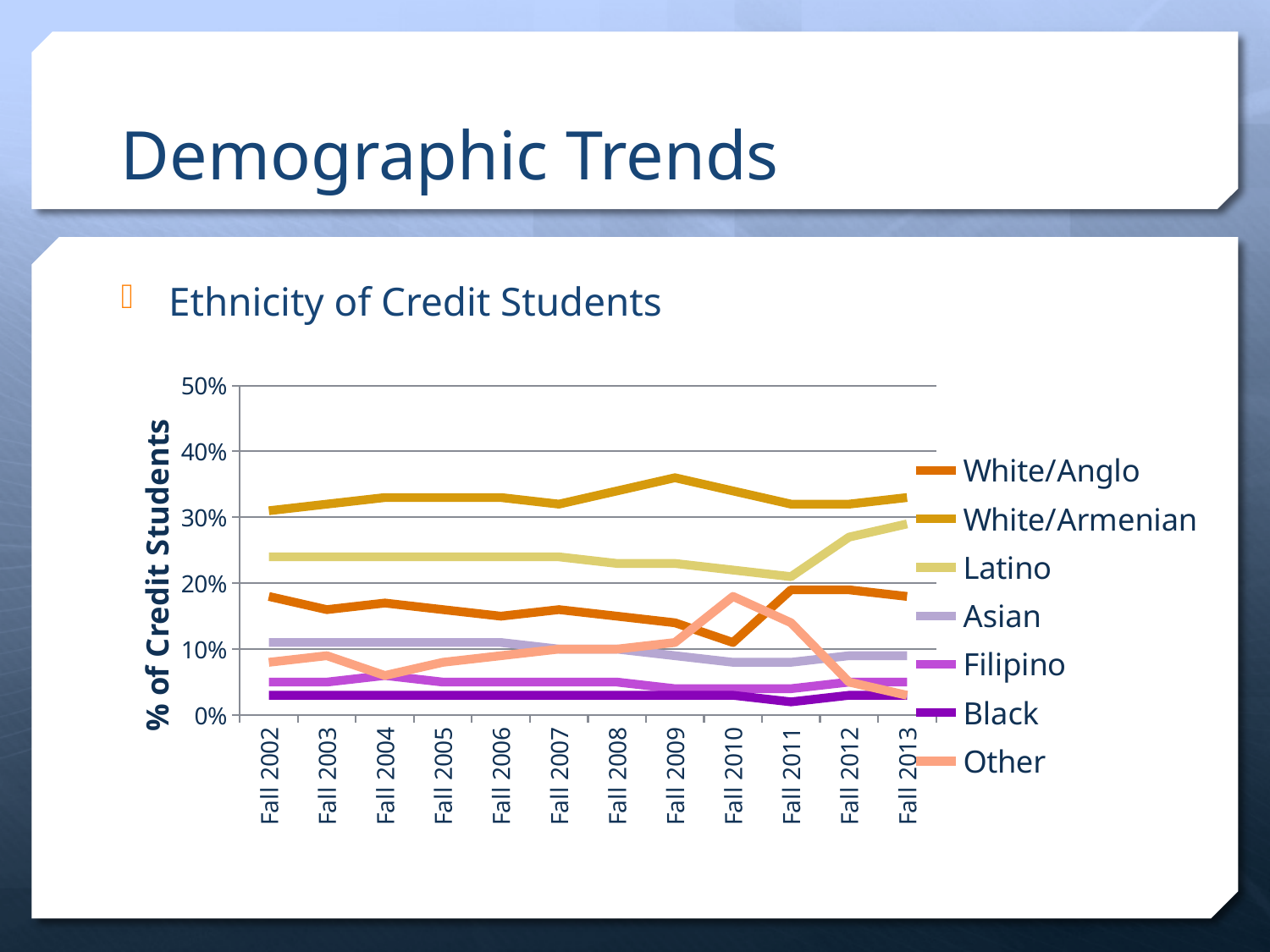
What kind of chart is shown on the slide? Line chart Does the Other series rise or fall from Fall 2010 to Fall 2013? Fall What is the label on the vertical axis? % of Credit Students Is the value for White/Anglo in Fall 2010 greater or less than 20%? less Is the value for Other in Fall 2010 greater or less than 10%? greater How many Fall terms are plotted along the x axis? 12 Which series has the highest value in Fall 2013? White/Armenian How many series does the legend list? 7 In Fall 2013, which is larger: Latino or White/Anglo? Latino Is the value for White/Armenian in Fall 2009 greater or less than 30%? greater Does the Latino series rise or fall from Fall 2011 to Fall 2013? Rise Which series has the lowest value in Fall 2002? Black